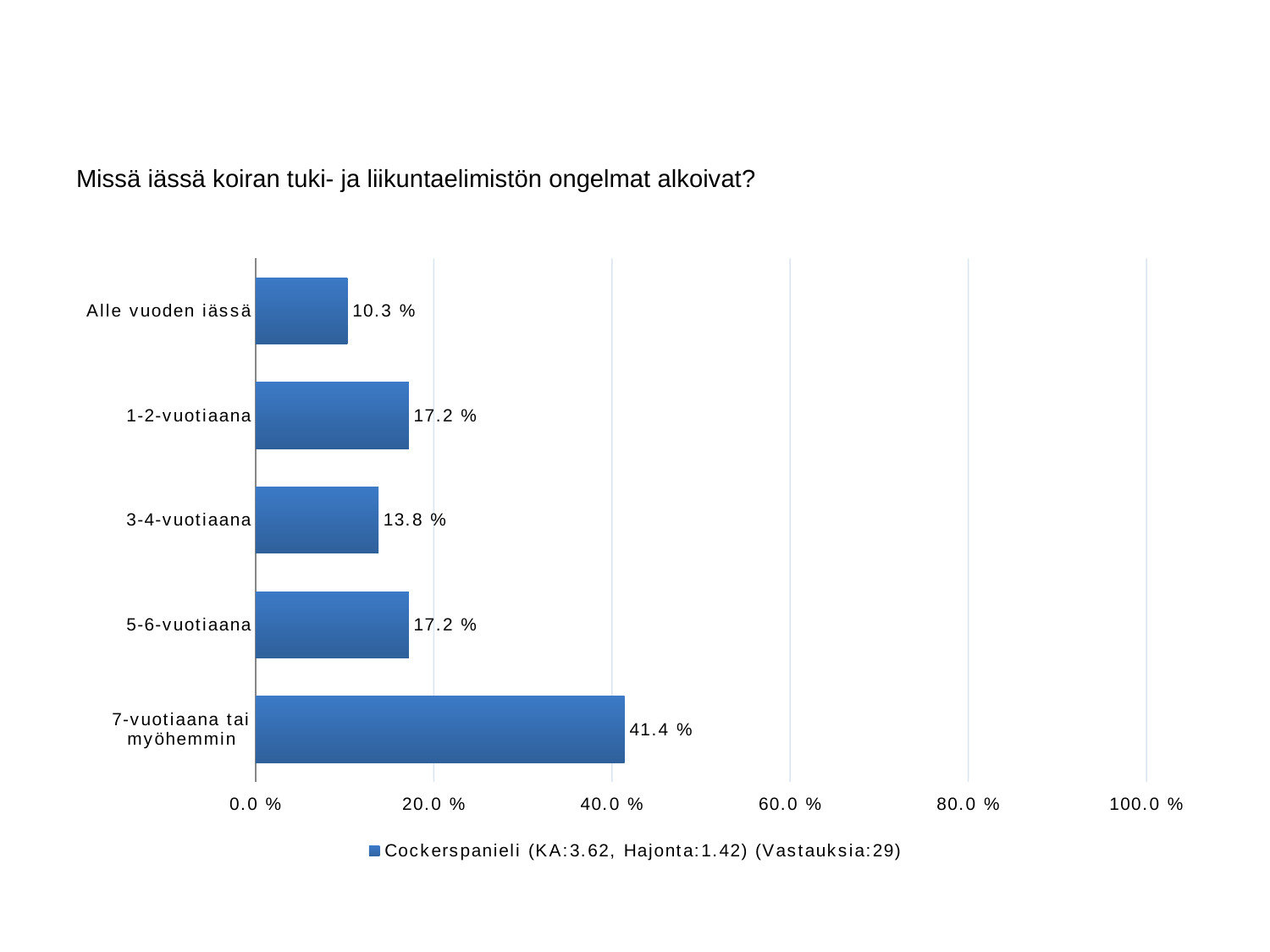
What is the value for "Alle vuoden iässä"? 10.3 % Is the value for "7-vuotiaana tai myöhemmin" greater or less than 40.0 %? greater What is the value for "7-vuotiaana tai myöhemmin"? 41.4 % Which category has the lowest value? Alle vuoden iässä How many series does the legend list? 1 Which category has the highest value? 7-vuotiaana tai myöhemmin Which is larger, the value for "3-4-vuotiaana" or the value for "5-6-vuotiaana"? 5-6-vuotiaana What is the title of the chart? Missä iässä koiran tuki- ja liikuntaelimistön ongelmat alkoivat? What is the difference between the values for "7-vuotiaana tai myöhemmin" and "1-2-vuotiaana"? 24.2 % How many categories are shown in the chart? 5 What kind of chart is shown on the slide? Bar chart What is the value for "3-4-vuotiaana"? 13.8 %